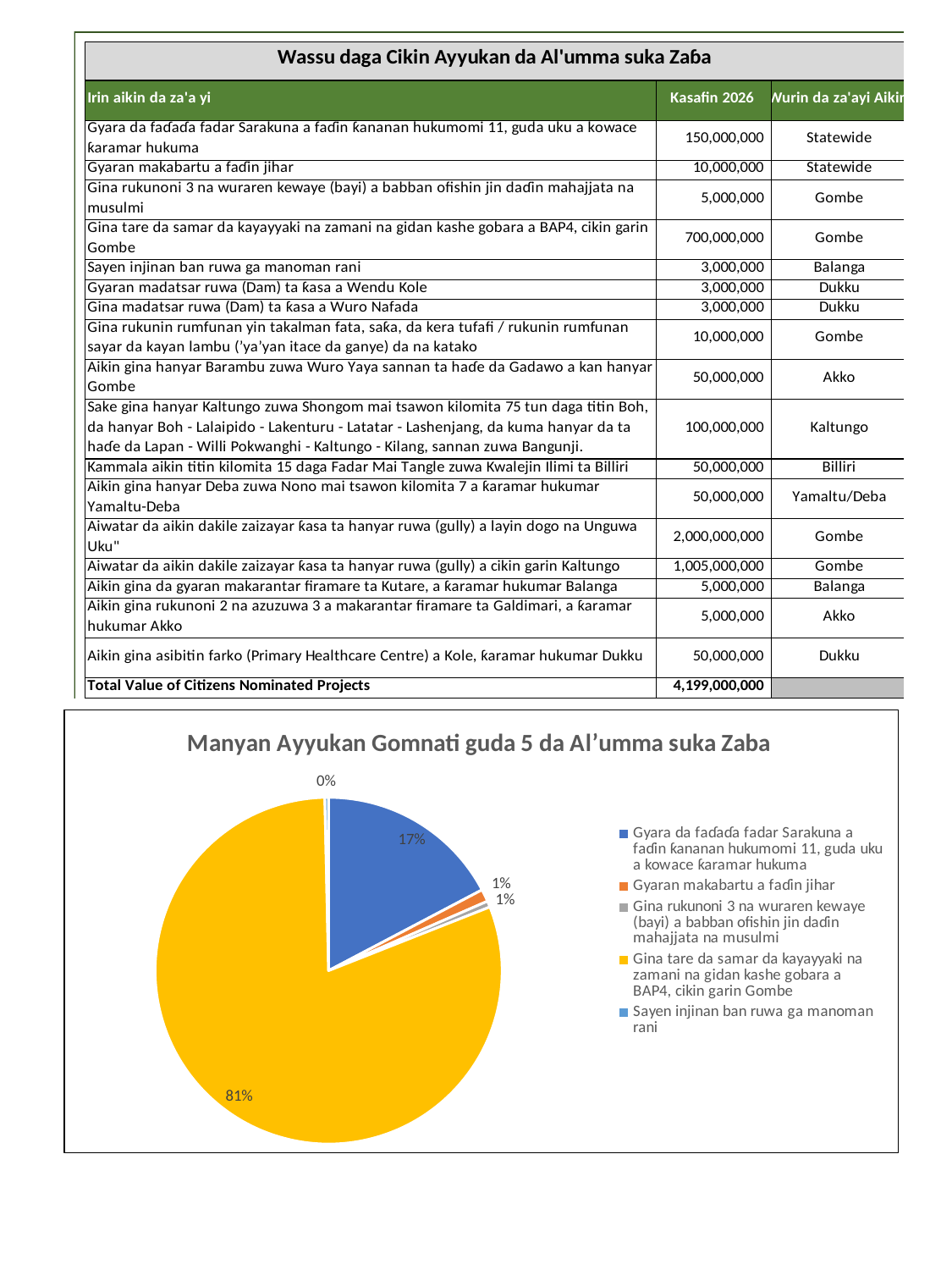
In the pie chart, what share is shown for "Gyara da fadada fadar Sarakuna a fadin kananan hukumomi 11, guda uku a kowace karamar hukuma"? 17% In the pie chart, what share is shown for "Gyaran makabartu a fadin jihar"? 1% Which slice of the pie chart is the smallest? Sayen injinan ban ruwa ga manoman rani In the pie chart, what is the difference in percentage points between the 81% slice and the 17% slice? 64 percentage points How many entries does the legend of the pie chart list? 5 What colour is the largest slice of the pie chart? Yellow What kind of chart is shown under the title "Manyan Ayyukan Gomnati guda 5 da Al'umma suka Zaba"? Pie chart In the pie chart, what share is shown for "Gina tare da samar da kayayyaki na zamani na gidan kashe gobara a BAP4, cikin garin Gombe"? 81% In the pie chart, which is larger: the share for "Gyara da fadada fadar Sarakuna..." or the share for "Gyaran makabartu a fadin jihar"? Gyara da fadada fadar Sarakuna... Which slice of the pie chart is the largest? Gina tare da samar da kayayyaki na zamani na gidan kashe gobara a BAP4, cikin garin Gombe What is the title of the pie chart? Manyan Ayyukan Gomnati guda 5 da Al'umma suka Zaba In the pie chart, what share is shown for "Sayen injinan ban ruwa ga manoman rani"? 0%